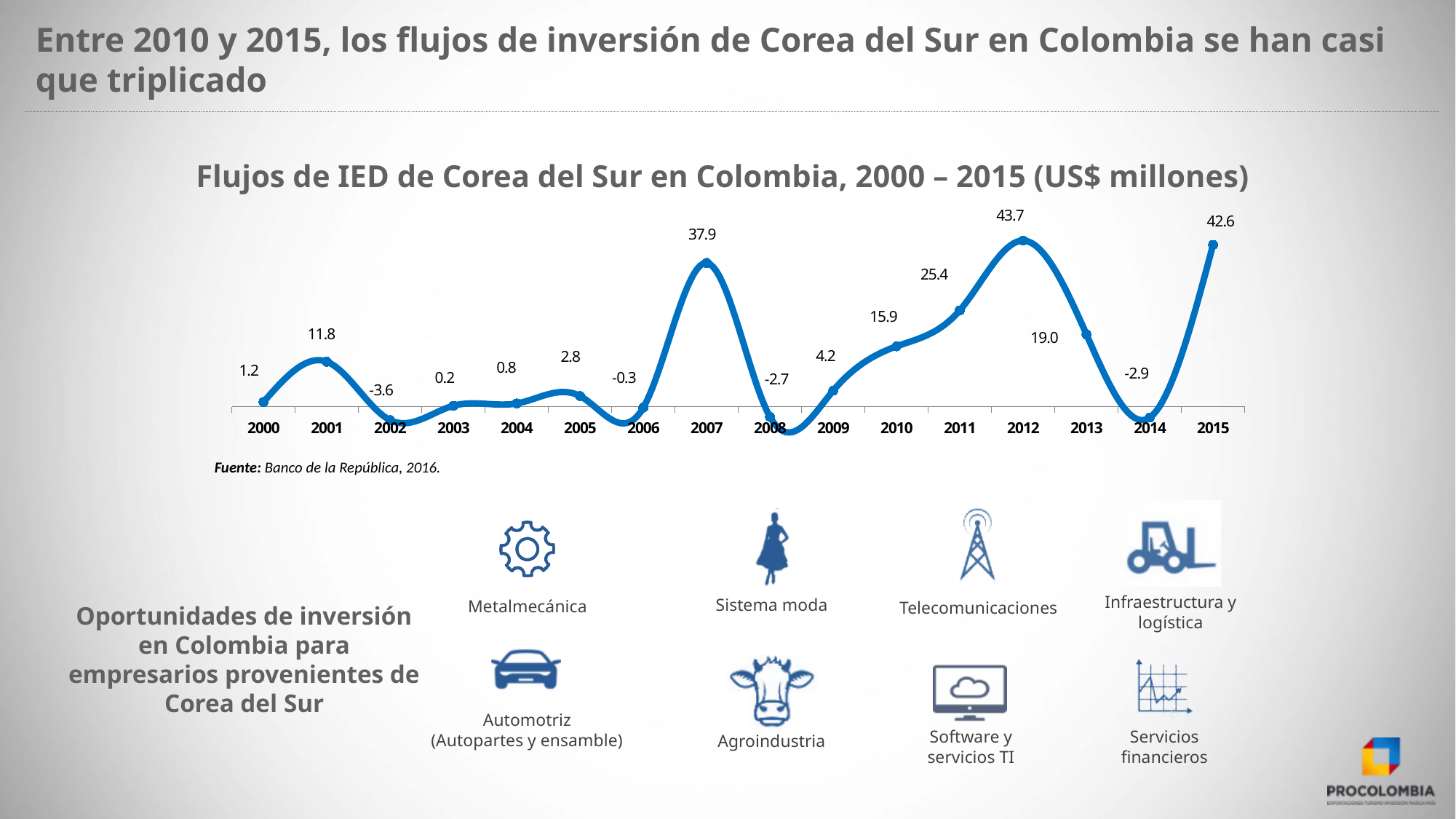
What kind of chart is shown? Line chart Which is larger, the value for 2007 or the value for 2015? 2015 What value is shown for 2015? 42.6 How many years are plotted on the x axis? 16 What was the FDI flow from South Korea to Colombia in 2007? 37.9 Which year has the lowest value? 2002 Which year has the highest value? 2012 What value is shown for 2002? -3.6 What is the difference between the values for 2015 and 2010? 26.7 What is the title of the chart? Flujos de IED de Corea del Sur en Colombia, 2000 – 2015 (US$ millones) Which is larger, the value for 2001 or the value for 2009? 2001 What is the difference between the values for 2012 and 2013? 24.7